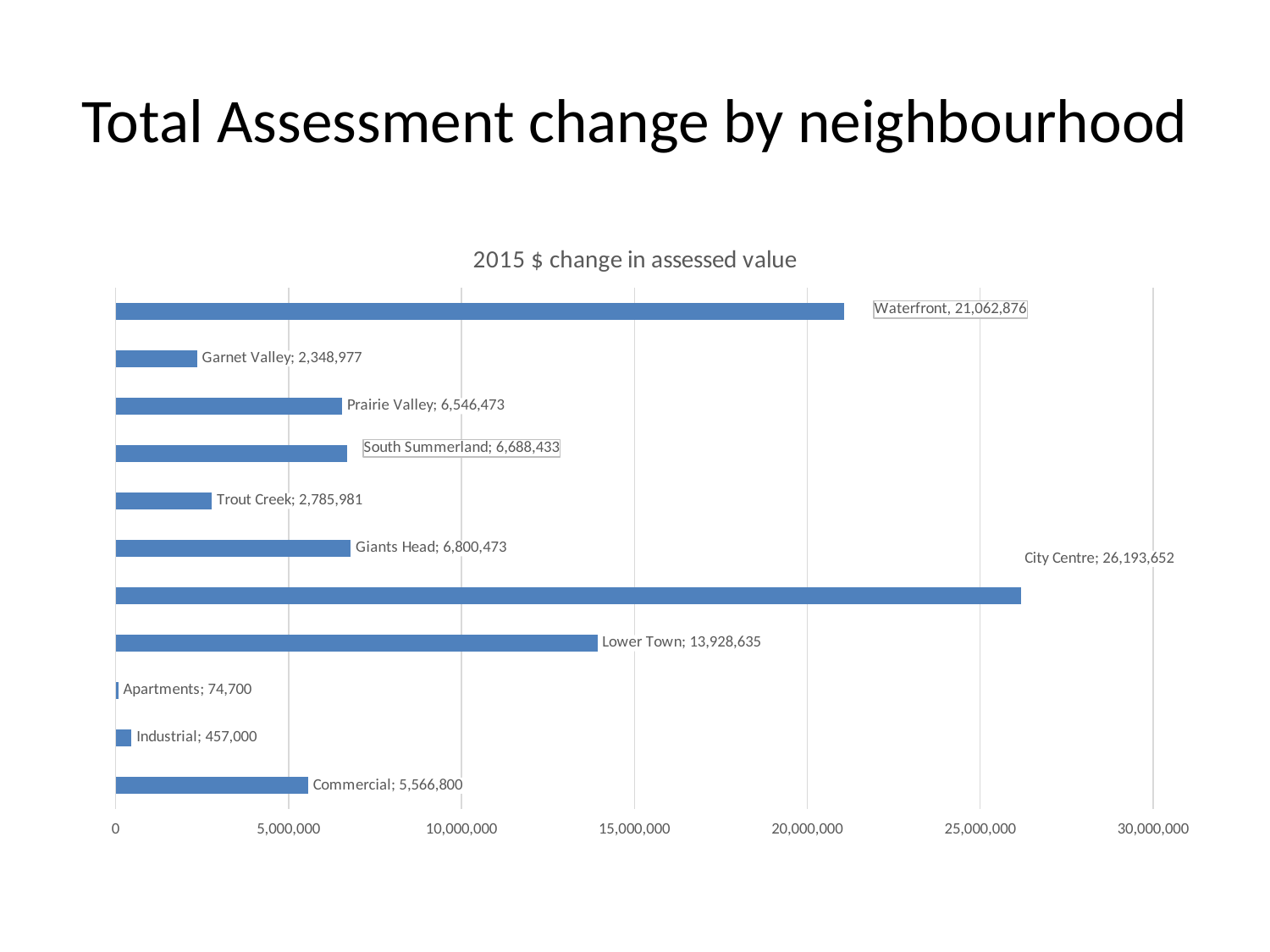
What is the value shown for Trout Creek? 2,785,981 What is the 2015 $ change in assessed value for Waterfront? 21,062,876 How many categories are plotted in the chart? 11 Which neighbourhood has the highest 2015 $ change in assessed value? City Centre Which is larger, the value for Garnet Valley or the value for Prairie Valley? Prairie Valley What kind of chart is shown on the slide? Bar chart Which category has the lowest 2015 $ change in assessed value? Apartments What is the title of the chart? 2015 $ change in assessed value What is the difference between the values for Lower Town and Commercial? 8,361,835 What is the difference between the values for City Centre and Waterfront? 5,130,776 What is the value shown for Lower Town? 13,928,635 What is the value shown for Apartments? 74,700